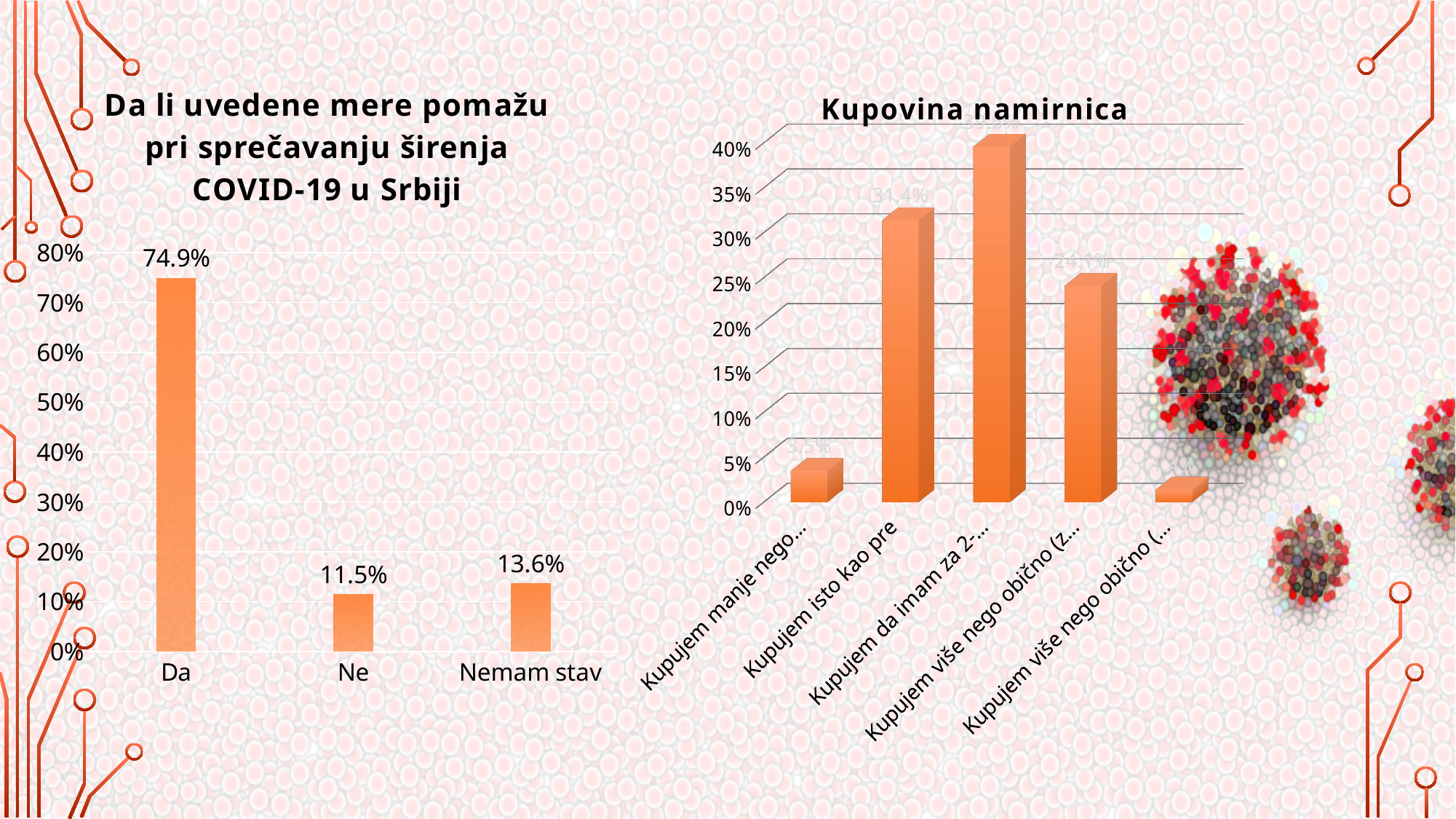
In the left chart (Da li uvedene mere pomažu...), which category has the lowest value? Ne In the left chart (Da li uvedene mere pomažu...), how many categories are shown? 3 In the right chart (Kupovina namirnica), what is the value for "Kupujem isto kao pre"? 31.4% In the left chart (Da li uvedene mere pomažu...), what is the value for "Ne"? 11.5% In the left chart (Da li uvedene mere pomažu...), what is the value for "Da"? 74.9% In the left chart (Da li uvedene mere pomažu...), which category has the highest value? Da In the left chart (Da li uvedene mere pomažu...), what is the value for "Nemam stav"? 13.6% In the right chart (Kupovina namirnica), is the value for "Kupujem da imam za 2-..." greater or less than 35%? greater In the left chart (Da li uvedene mere pomažu...), what is the difference between the values for "Da" and "Ne"? 63.4% In the right chart (Kupovina namirnica), how many bars are shown? 5 In the left chart (Da li uvedene mere pomažu...), which is larger, the value for "Ne" or for "Nemam stav"? Nemam stav What kind of chart is the right chart (Kupovina namirnica)? bar chart